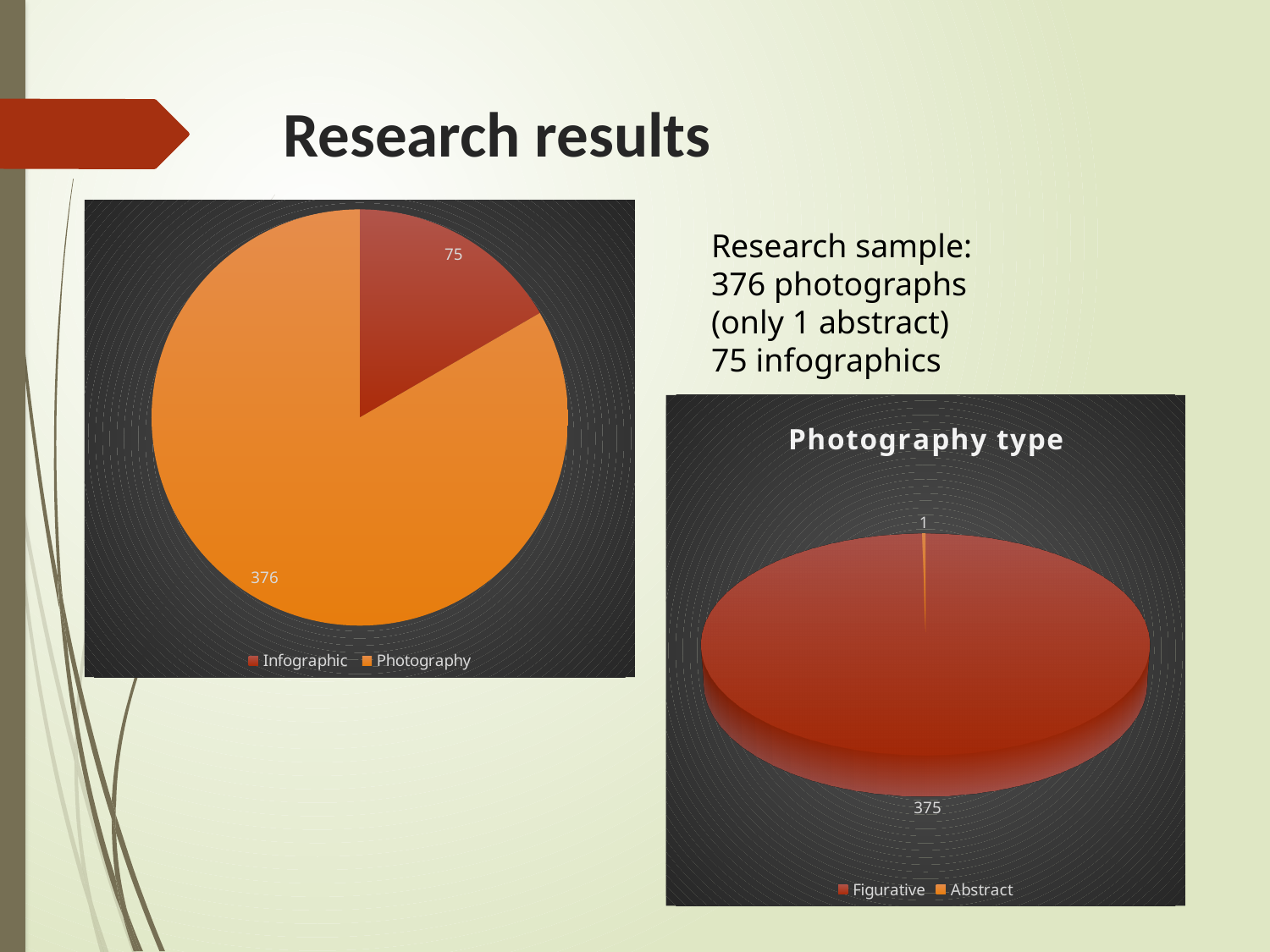
On the left pie chart, what is the value for Infographic? 75 On the 'Photography type' chart, which category has the smallest value? Abstract On the 'Photography type' chart, what is the total of the two slices? 376 On the 'Photography type' chart, what is the value for Figurative? 375 On the left pie chart, which category has the larger value? Photography What is the title of the chart on the right of the slide? Photography type On the left pie chart, what is the difference between the Photography and Infographic values? 301 What kind of chart is the chart on the left of the slide? Pie chart On the 'Photography type' chart, what is the value for Abstract? 1 On the left pie chart, how many categories does the legend list? 2 On the left pie chart, what is the value for Photography? 376 On the 'Photography type' chart, what is the difference between the Figurative and Abstract values? 374